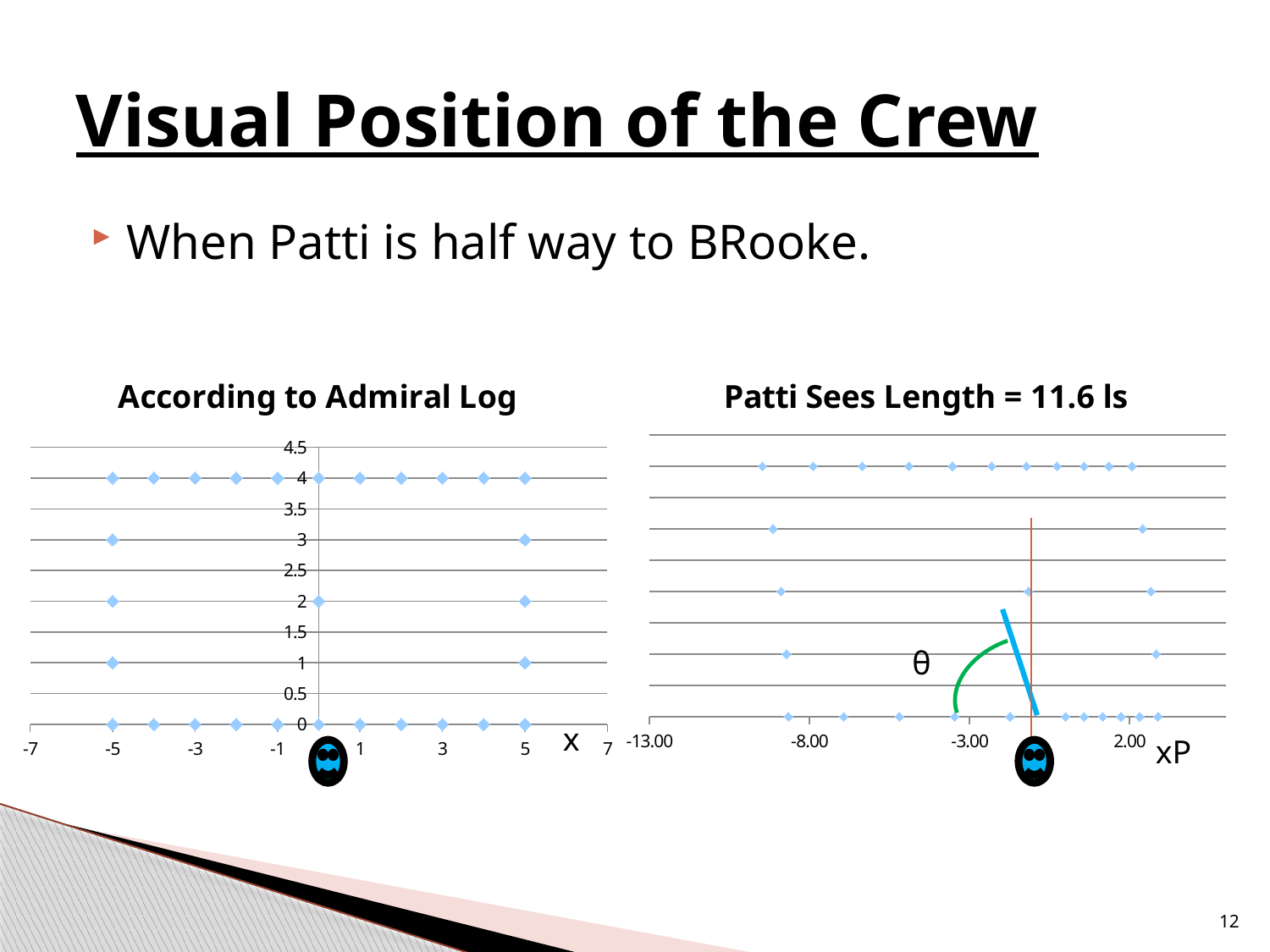
In the "According to Admiral Log" chart, what is the highest y value reached by any plotted point? 4 In the "According to Admiral Log" chart, what is the difference between the y values of the top row and the bottom row of points? 4 In the "According to Admiral Log" chart, how many points lie on the top row at y = 4? 11 In the "According to Admiral Log" chart, what is the lowest y value of the plotted points? 0 In the "According to Admiral Log" chart, how many points are plotted at x = -5? 5 In the "According to Admiral Log" chart, what is the y value of the point plotted at x = 0 between the top and bottom rows? 2 What kind of chart is the left chart titled "According to Admiral Log"? scatter chart What is the title of the right chart? Patti Sees Length = 11.6 ls In the "Patti Sees Length = 11.6 ls" chart, what is the leftmost x-axis tick label? -13.00 In the "According to Admiral Log" chart, what is the largest x-axis tick label shown? 7 In the "Patti Sees Length = 11.6 ls" chart, what is the rightmost x-axis tick label? 2.00 What length does the title of the right chart say Patti sees? 11.6 ls